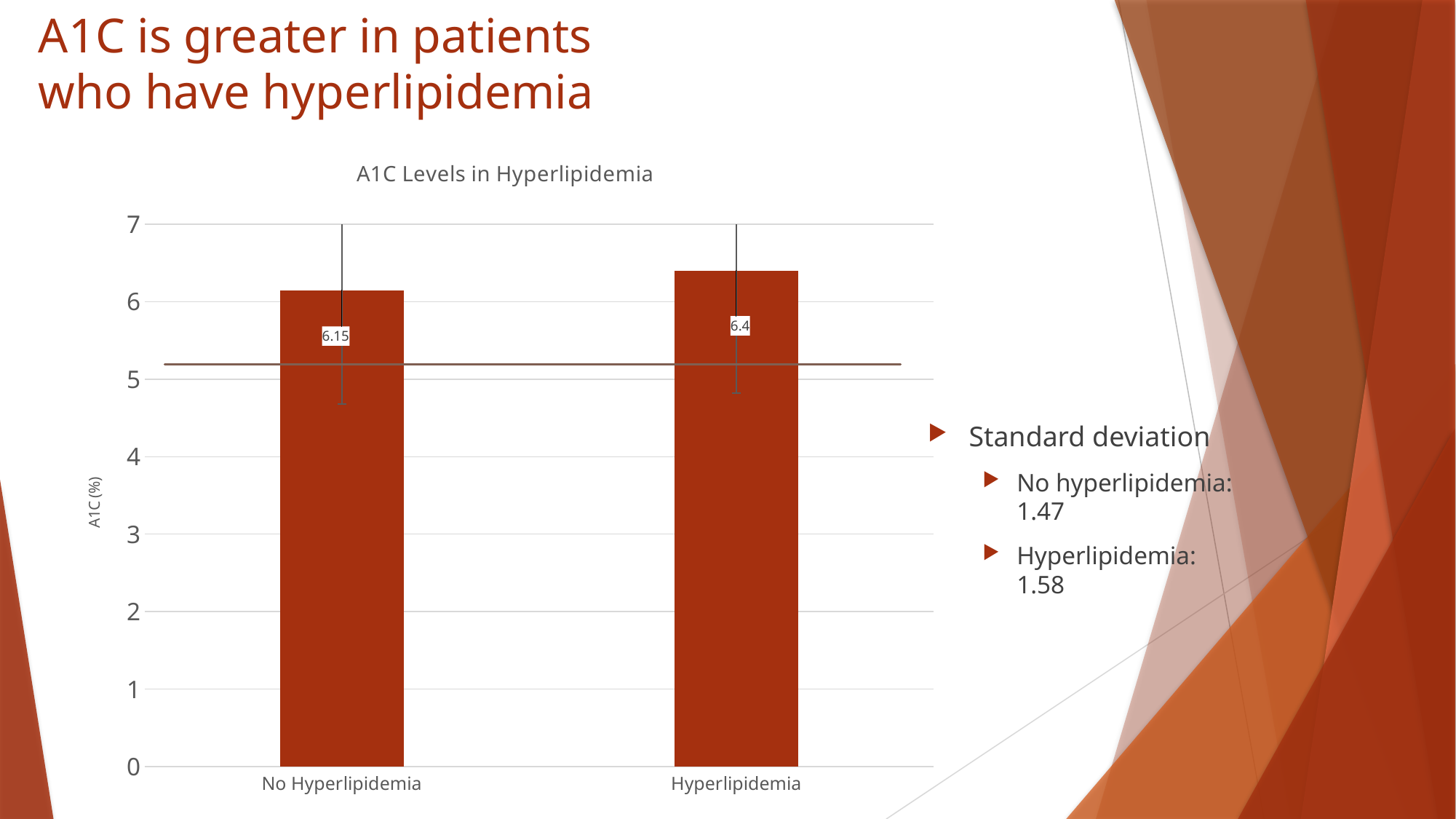
Is the value for Hyperlipidemia greater or less than 7? less What is the title of the chart? A1C Levels in Hyperlipidemia What is the difference between the A1C values for Hyperlipidemia and No Hyperlipidemia? 0.25 How many categories are shown on the x axis? 2 Is the value for No Hyperlipidemia greater or less than 6? greater Which category has the higher A1C value? Hyperlipidemia What is the A1C value for No Hyperlipidemia? 6.15 Is the A1C value for Hyperlipidemia larger or smaller than the value for No Hyperlipidemia? larger Which category has the lower A1C value? No Hyperlipidemia What is the A1C value for Hyperlipidemia? 6.4 What kind of chart is shown on the slide? bar chart What is the label of the vertical axis? A1C (%)